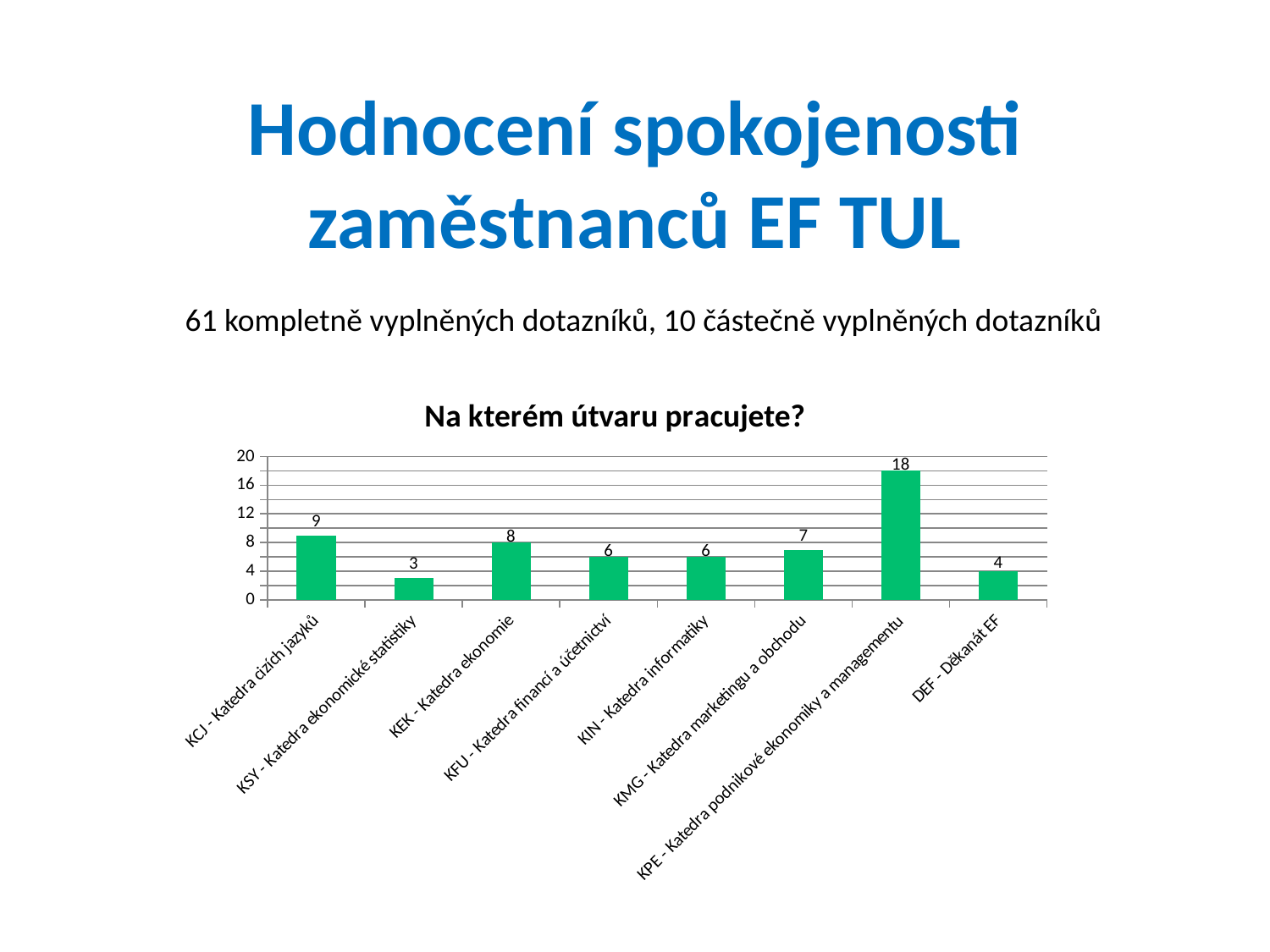
What is the difference between the values for KFU - Katedra financí a účetnictví and KSY - Katedra ekonomické statistiky? 3 Which category has the highest value? KPE - Katedra podnikové ekonomiky a managementu Is the value for KPE - Katedra podnikové ekonomiky a managementu greater or less than 16? greater Which is larger, the value for KEK - Katedra ekonomie or the value for KMG - Katedra marketingu a obchodu? KEK - Katedra ekonomie What is the title of the chart? Na kterém útvaru pracujete? What is the value for KPE - Katedra podnikové ekonomiky a managementu? 18 How many categories are shown on the x axis? 8 What kind of chart is shown on the slide? bar chart What is the difference between the values for KPE - Katedra podnikové ekonomiky a managementu and KCJ - Katedra cizích jazyků? 9 What is the value for DEF - Děkanát EF? 4 What is the value for KCJ - Katedra cizích jazyků? 9 Which category has the lowest value? KSY - Katedra ekonomické statistiky